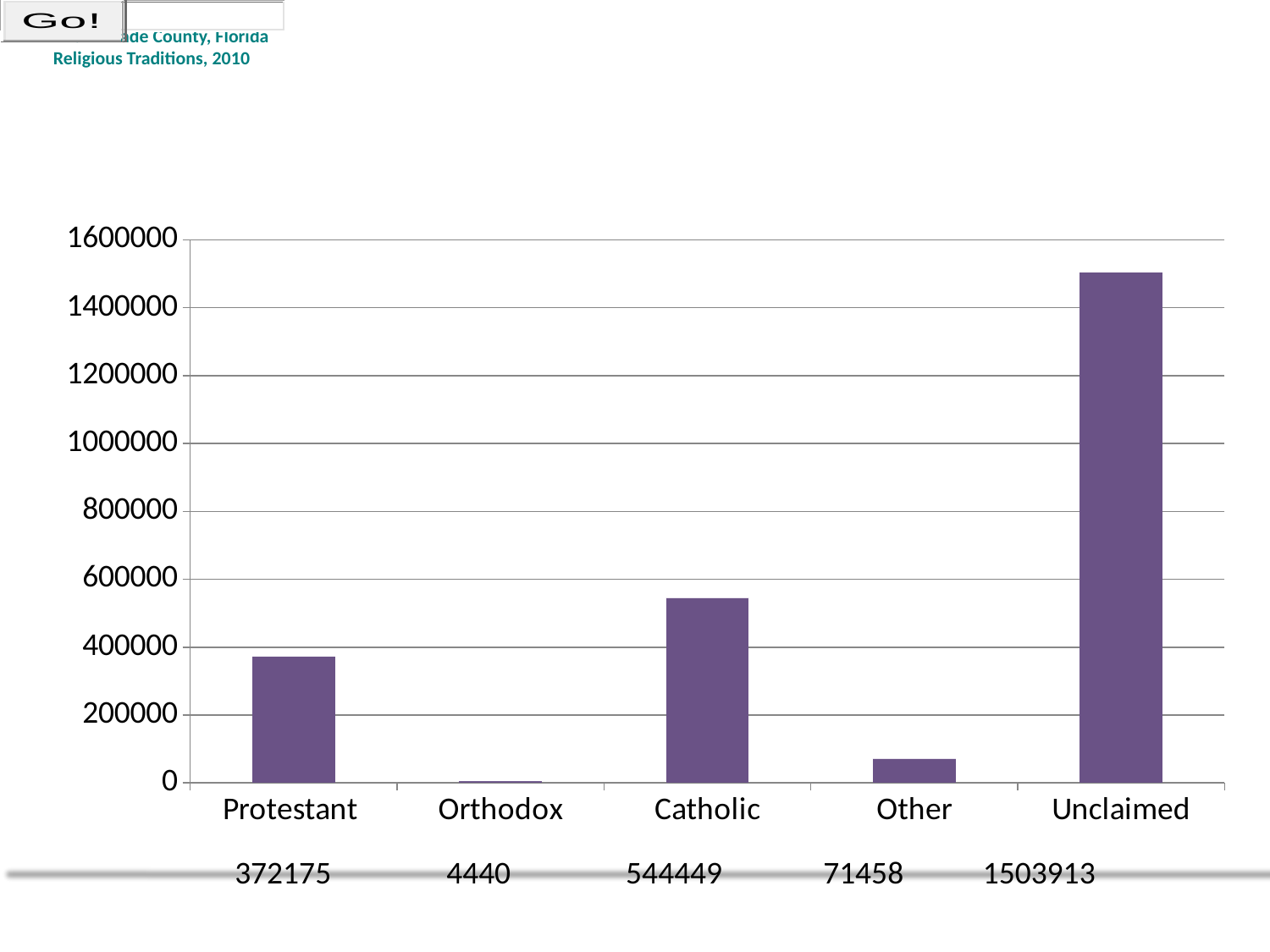
Which category has the lowest value? Orthodox What is the value for Protestant? 372175 What is the value for Catholic? 544449 What is the value for Unclaimed? 1503913 What is the value for Orthodox? 4440 Which category has the highest value? Unclaimed How many categories are shown on the x axis? 5 Which is larger, the value for Other or the value for Protestant? Protestant What is the difference between the Catholic and Protestant values? 172274 What kind of chart is shown on the slide? bar chart Is the value for Unclaimed greater or less than 1400000? greater What is the value for Other? 71458